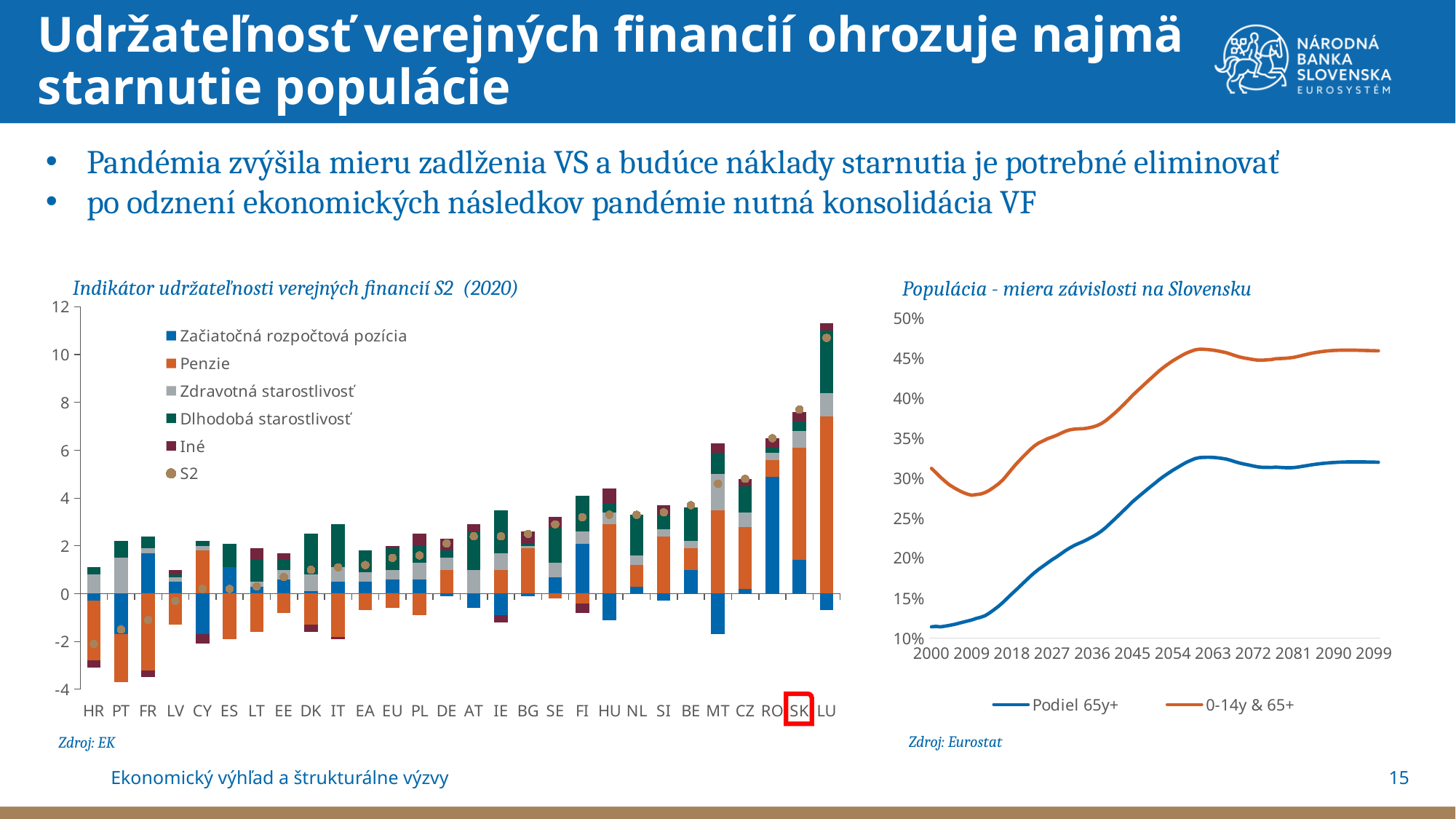
In the chart 'Indikátor udržateľnosti verejných financií S2 (2020)', which country has the highest S2 marker? LU In the chart 'Indikátor udržateľnosti verejných financií S2 (2020)', is the S2 value for SK greater or less than 6? greater What kind of chart is 'Populácia - miera závislosti na Slovensku'? Line chart In the chart 'Indikátor udržateľnosti verejných financií S2 (2020)', which country has the lowest S2 marker? HR In the chart 'Indikátor udržateľnosti verejných financií S2 (2020)', how many countries or regions are shown on the x axis? 28 In the chart 'Indikátor udržateľnosti verejných financií S2 (2020)', is the S2 value for HR greater or less than 0? less In the chart 'Populácia - miera závislosti na Slovensku', does the 'Podiel 65y+' line rise or fall overall from 2000 to 2099? Rises In the chart 'Populácia - miera závislosti na Slovensku', is the value of 'Podiel 65y+' in 2000 greater or less than 15%? less In the chart 'Indikátor udržateľnosti verejných financií S2 (2020)', how many entries does the legend list? 6 In the chart 'Populácia - miera závislosti na Slovensku', how many series does the legend list? 2 In the chart 'Indikátor udržateľnosti verejných financií S2 (2020)', which country is highlighted with a red box on the x axis? SK What kind of chart is 'Indikátor udržateľnosti verejných financií S2 (2020)'? Stacked bar chart